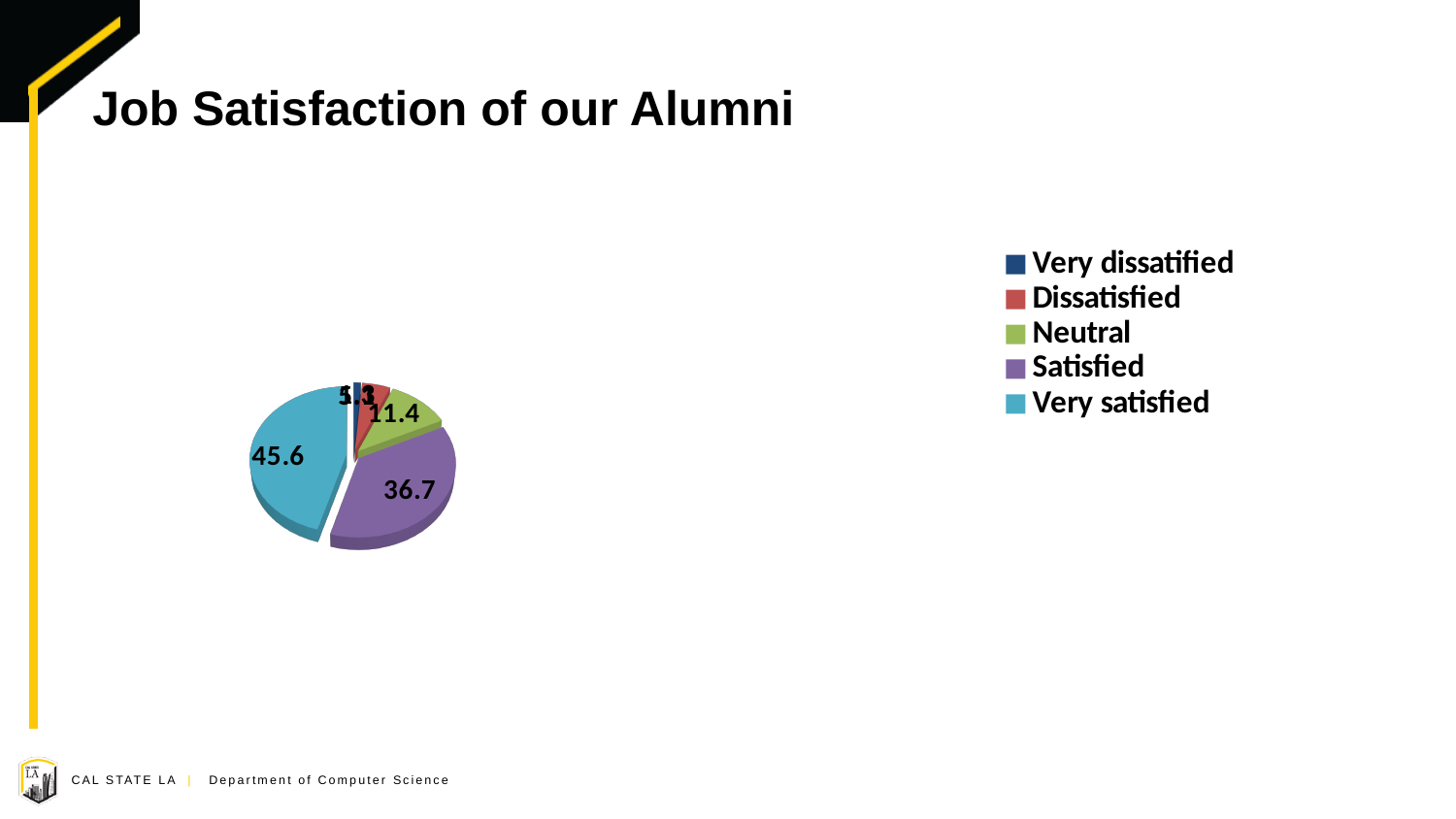
Which is larger, the Satisfied slice or the Neutral slice? Satisfied What value is shown for the Very satisfied slice? 45.6 What value is shown for the Satisfied slice? 36.7 What colour represents the Neutral category in the legend? Green What is the difference between the Very satisfied value and the Satisfied value? 8.9 What type of chart is shown on the slide? Pie chart What is the title of the chart on the slide? Job Satisfaction of our Alumni Which category has the largest slice of the pie? Very satisfied What is the difference between the Satisfied value and the Neutral value? 25.3 What value is shown for the Neutral slice? 11.4 Which category has the smallest slice of the pie? Very dissatisfied How many categories does the legend list? 5